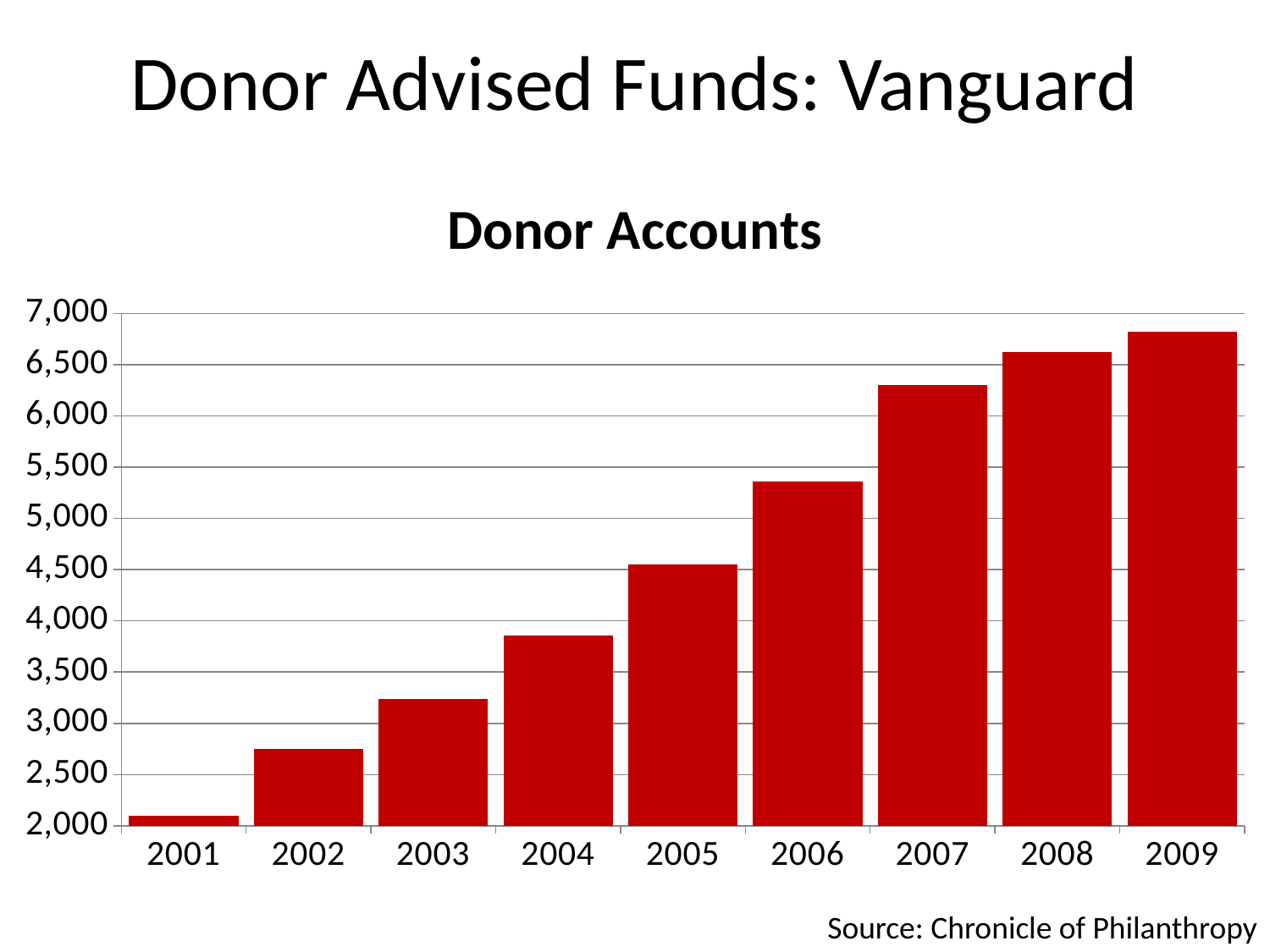
How many years are shown on the x axis of the chart? 9 Which year has the highest number of donor accounts? 2009 What is the title of the chart? Donor Accounts Which year has the lowest number of donor accounts? 2001 Is the value for 2003 greater or less than 3,000? greater What source is cited for the chart data? Chronicle of Philanthropy Is the value for 2007 greater or less than 6,000? greater Is the value for 2004 greater or less than 4,000? less Which year has more donor accounts, 2004 or 2006? 2006 Do the donor account values rise or fall from 2001 to 2009? Rise What kind of chart is shown on the slide? Bar chart